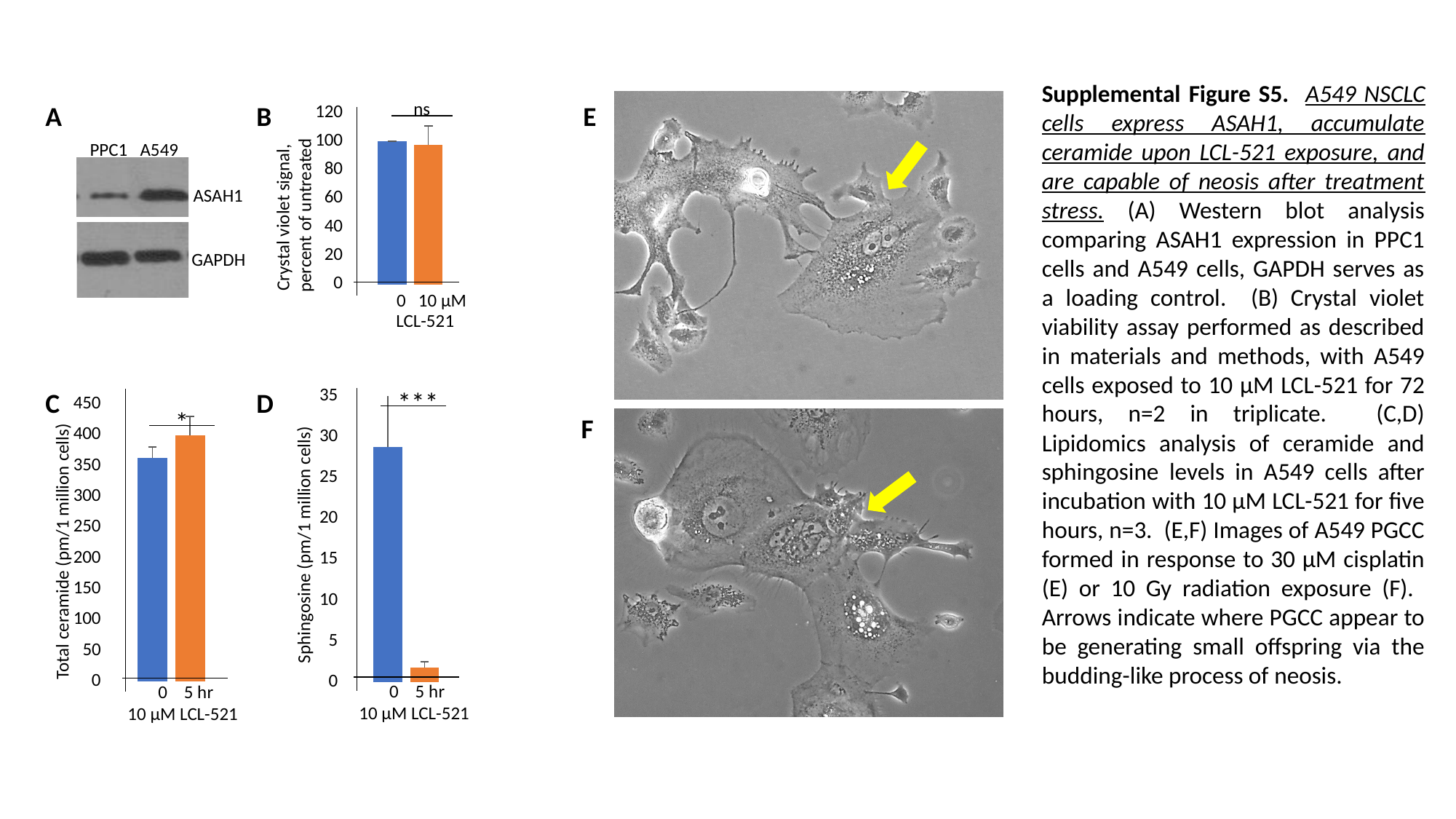
In chart D (Sphingosine), is the value for the 0 bar greater or less than 25? greater What is the y-axis label of chart C? Total ceramide (pm/1 million cells) In chart B (Crystal violet signal), is the value for the 10 µM LCL-521 bar greater or less than 80? greater What is the x-axis label shown beneath chart D? 10 µM LCL-521 In chart C (Total ceramide), is the value for the 0 bar greater or less than 400? less In chart D (Sphingosine), which bar is taller, 0 or 5 hr? 0 In chart D (Sphingosine), do the values rise or fall from 0 to 5 hr? fall What kind of chart is chart B (Crystal violet signal)? bar chart In chart B (Crystal violet signal), how many bars are plotted? 2 In chart C (Total ceramide), which bar is taller, 0 or 5 hr? 5 hr